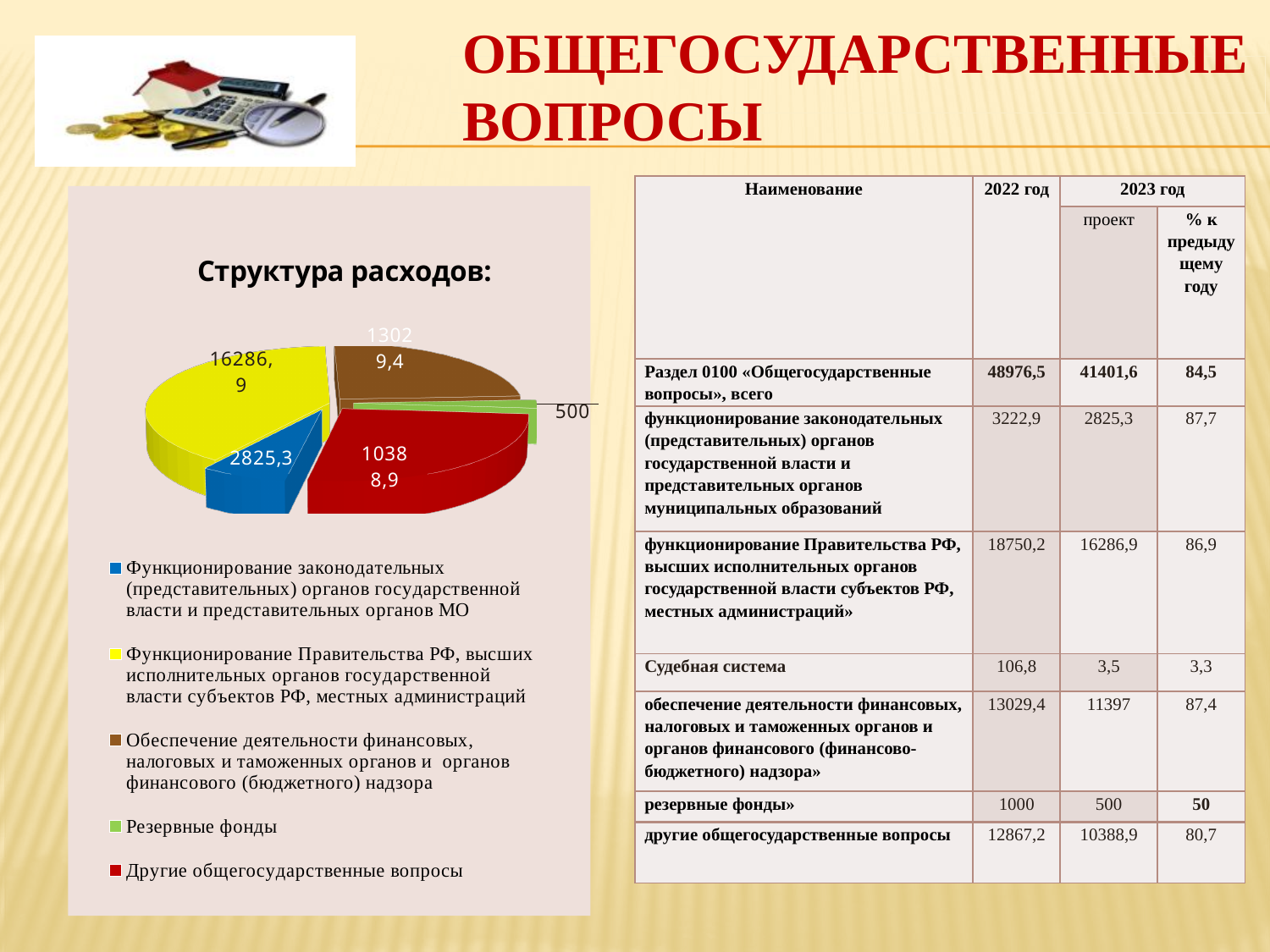
Which category has the largest slice in the pie chart? Функционирование Правительства РФ, высших исполнительных органов государственной власти субъектов РФ, местных администраций In the pie chart, which is larger: the slice for "Функционирование Правительства РФ..." or the slice for "Другие общегосударственные вопросы"? Функционирование Правительства РФ, высших исполнительных органов государственной власти субъектов РФ, местных администраций What value is shown on the pie chart for "Функционирование законодательных (представительных) органов государственной власти и представительных органов МО"? 2825,3 In the pie chart, what is the difference between the value for "Функционирование законодательных (представительных) органов..." (2825,3) and the value for "Резервные фонды" (500)? 2325,3 What is the title of the chart on the left of the slide? Структура расходов: What value is shown on the pie chart for "Функционирование Правительства РФ, высших исполнительных органов государственной власти субъектов РФ, местных администраций"? 16286,9 Which category has the smallest slice in the pie chart? Резервные фонды What colour represents "Резервные фонды" in the pie chart? green How many categories does the legend of the pie chart list? 5 What kind of chart is shown under the title "Структура расходов:"? pie chart What value is shown on the pie chart for "Резервные фонды"? 500 In the pie chart, which is larger: the value for "Функционирование законодательных (представительных) органов..." or the value for "Резервные фонды"? Функционирование законодательных (представительных) органов государственной власти и представительных органов МО